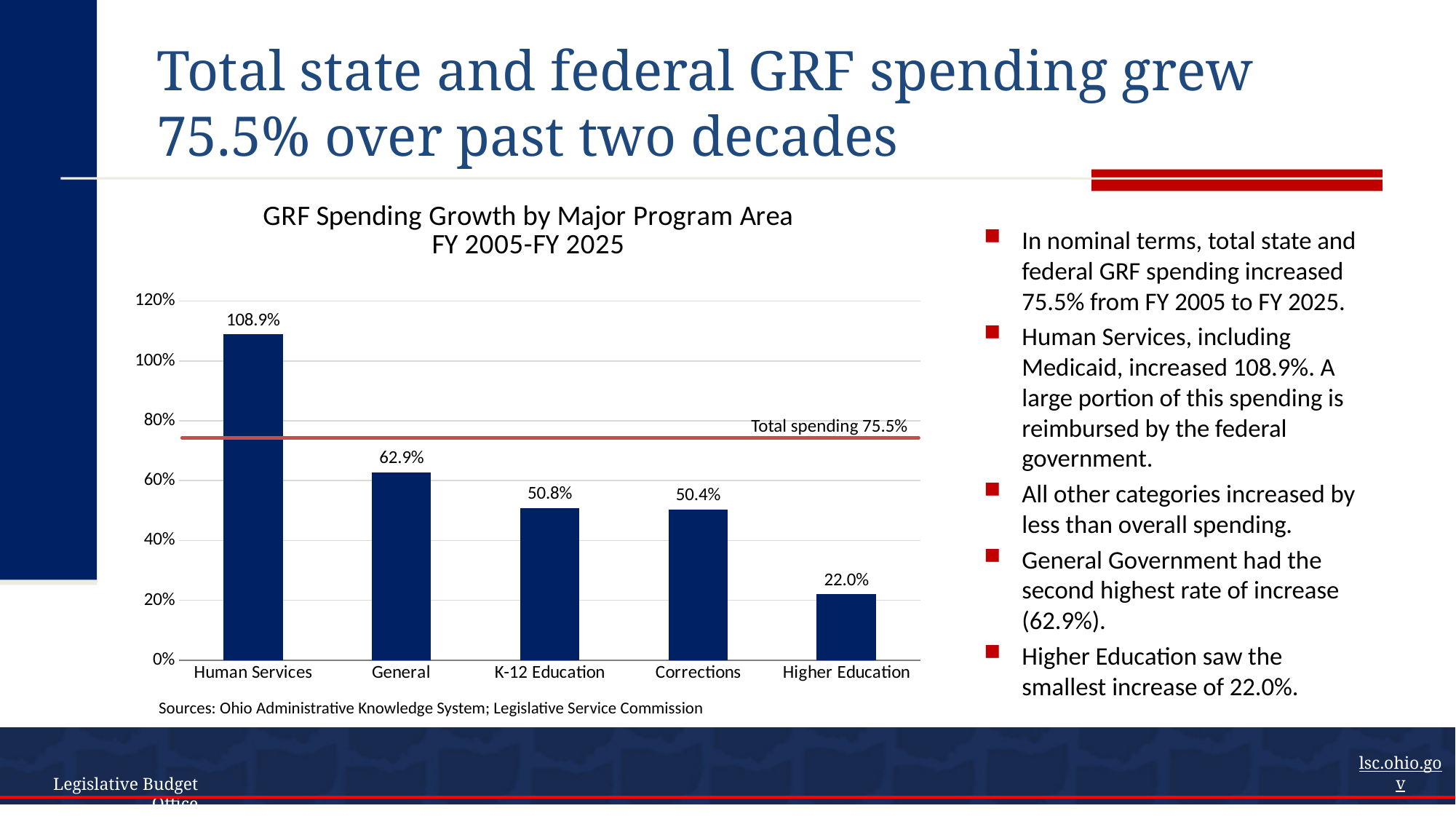
What is the GRF spending growth for Higher Education? 22.0% Which has higher spending growth, General or Corrections? General What is the difference between the growth for Human Services and General? 46.0% Which program area has the highest spending growth? Human Services Which program area has the lowest spending growth? Higher Education How many program areas are shown on the chart? 5 What value does the horizontal reference line on the chart represent? Total spending 75.5% What is the GRF spending growth for K-12 Education? 50.8% What is the title of the chart? GRF Spending Growth by Major Program Area FY 2005-FY 2025 Is the value for Corrections greater or less than 60%? less What kind of chart is shown on the slide? Bar chart What is the GRF spending growth for Human Services? 108.9%